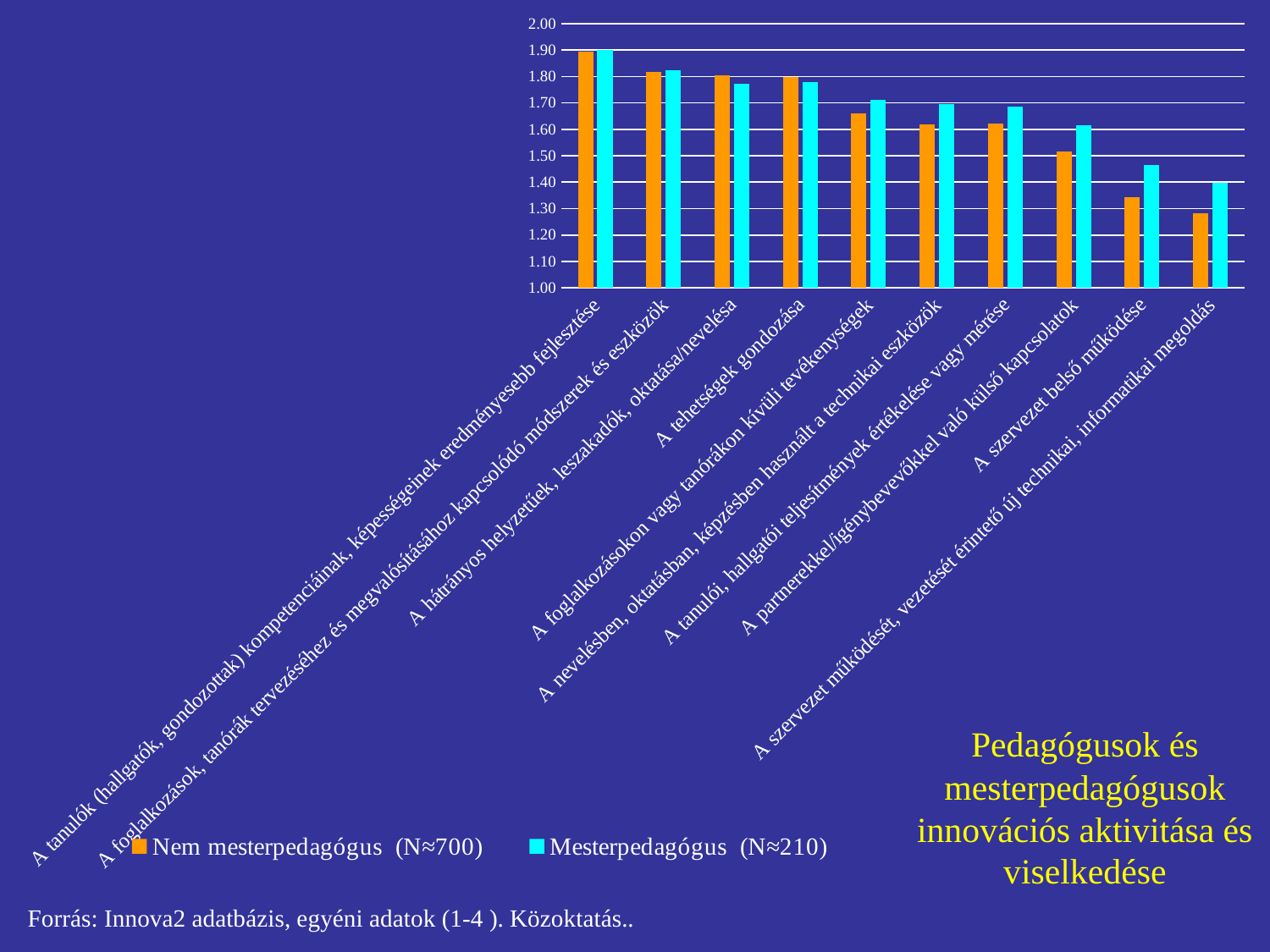
How many series does the legend list? 2 Is the Nem mesterpedagógus (N≈700) value for 'A szervezet belső működése' greater or less than 1.40? less For 'A szervezet belső működése', which series has the larger value: Nem mesterpedagógus (N≈700) or Mesterpedagógus (N≈210)? Mesterpedagógus (N≈210) What kind of chart is shown on the slide? bar chart Is the Nem mesterpedagógus (N≈700) value for 'A tehetségek gondozása' greater or less than 1.70? greater Which category has the highest value for the Mesterpedagógus (N≈210) series? A tanulók (hallgatók, gondozottak) kompetenciáinak, képességeinek eredményesebb fejlesztése Which colour represents the Mesterpedagógus (N≈210) series in the legend? cyan How many categories are shown on the x axis of the chart? 10 What is the title text shown next to the chart? Pedagógusok és mesterpedagógusok innovációs aktivitása és viselkedése Which category has the lowest value for the Nem mesterpedagógus (N≈700) series? A szervezet működését, vezetését érintető új technikai, informatikai megoldás Is the Mesterpedagógus (N≈210) value for 'A partnerekkel/igénybevevőkkel való külső kapcsolatok' greater or less than 1.50? greater Do the values generally rise or fall moving from left to right along the x axis? fall